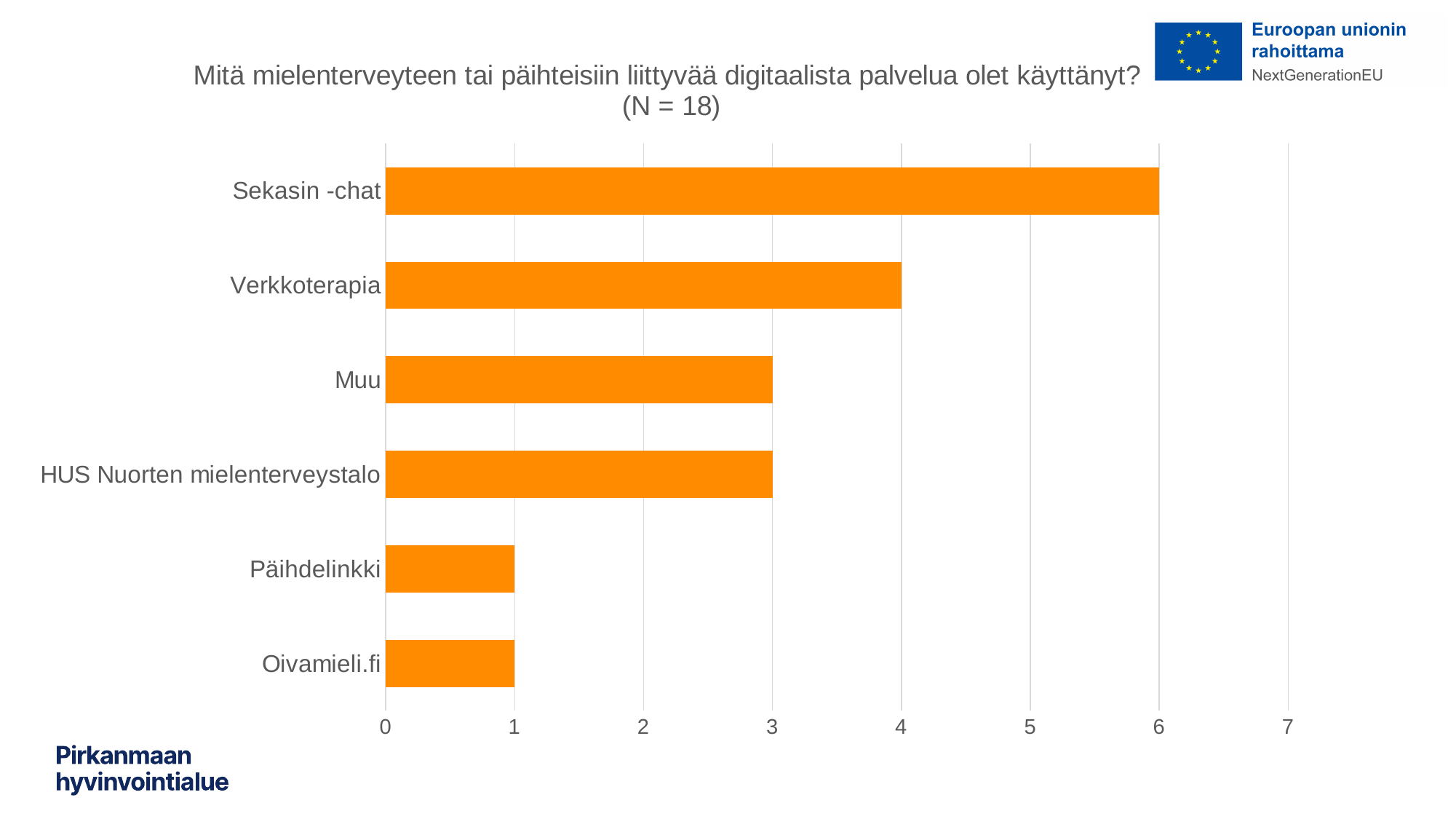
Which category has the highest value? Sekasin -chat What is the value for Verkkoterapia? 4 What is the value for Päihdelinkki? 1 What kind of chart is shown on the slide? bar chart What is the N (number of respondents) stated in the chart title? 18 What is the value for HUS Nuorten mielenterveystalo? 3 What is the difference between the values for Sekasin -chat and Verkkoterapia? 2 What colour are the bars in the chart? orange How many categories are shown in the chart? 6 Is the value for Verkkoterapia greater or less than 5? less Which is larger, the value for Muu or the value for Oivamieli.fi? Muu What is the value for Sekasin -chat? 6